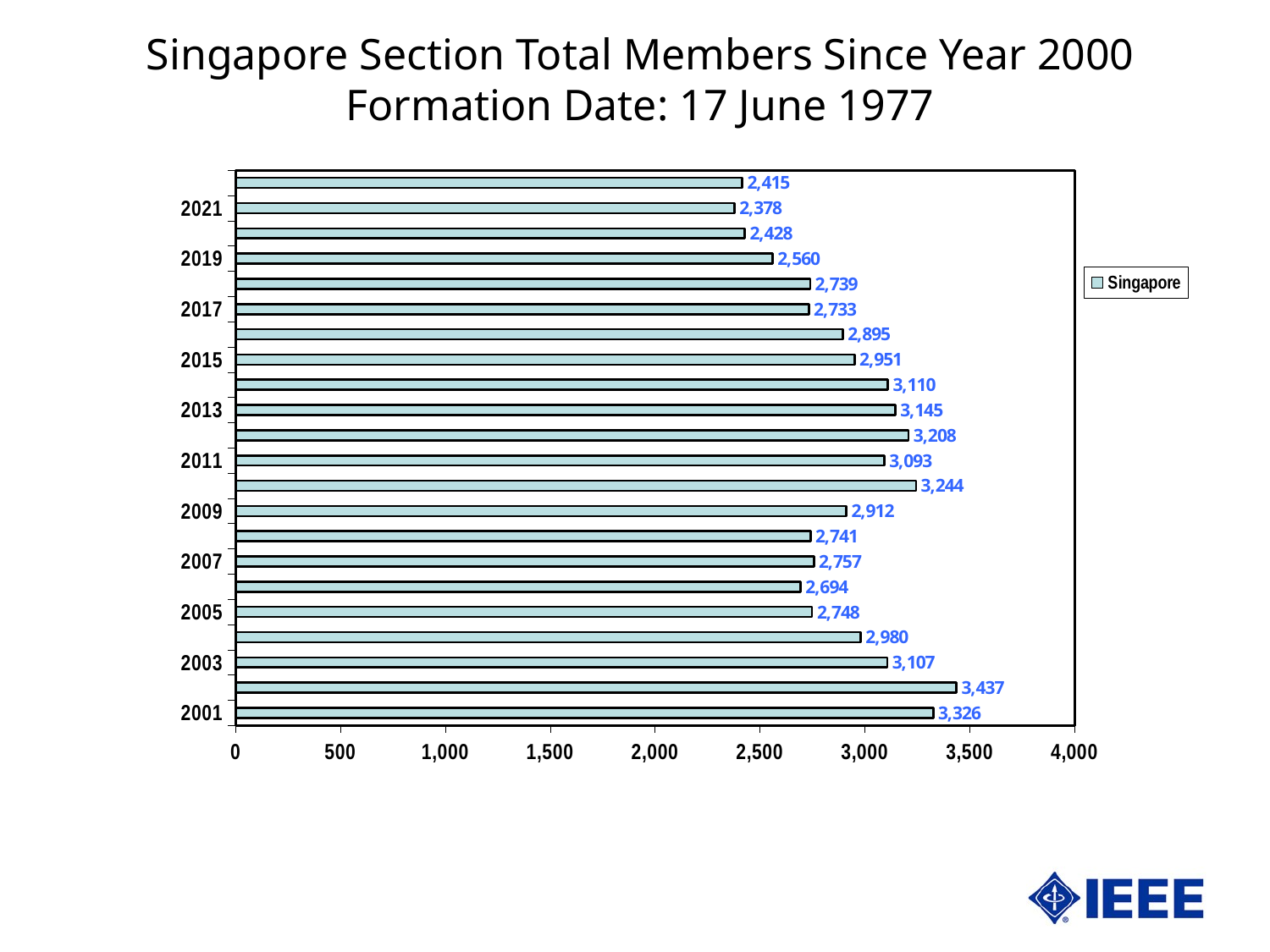
How many series does the legend list? 1 Do the values rise or fall from 2015 to 2021? fall Which is larger, the value for 2013 or the value for 2015? 2013 Is the value for 2019 greater or less than 3,000? less How many bars are plotted on the chart? 22 What is the value for 2001? 3,326 What is the value for 2021? 2,378 Which year has the lowest value? 2021 What is the difference between the values for 2001 and 2021? 948 What is the highest value shown on the chart? 3,437 What kind of chart is shown? bar chart What is the value for 2009? 2,912